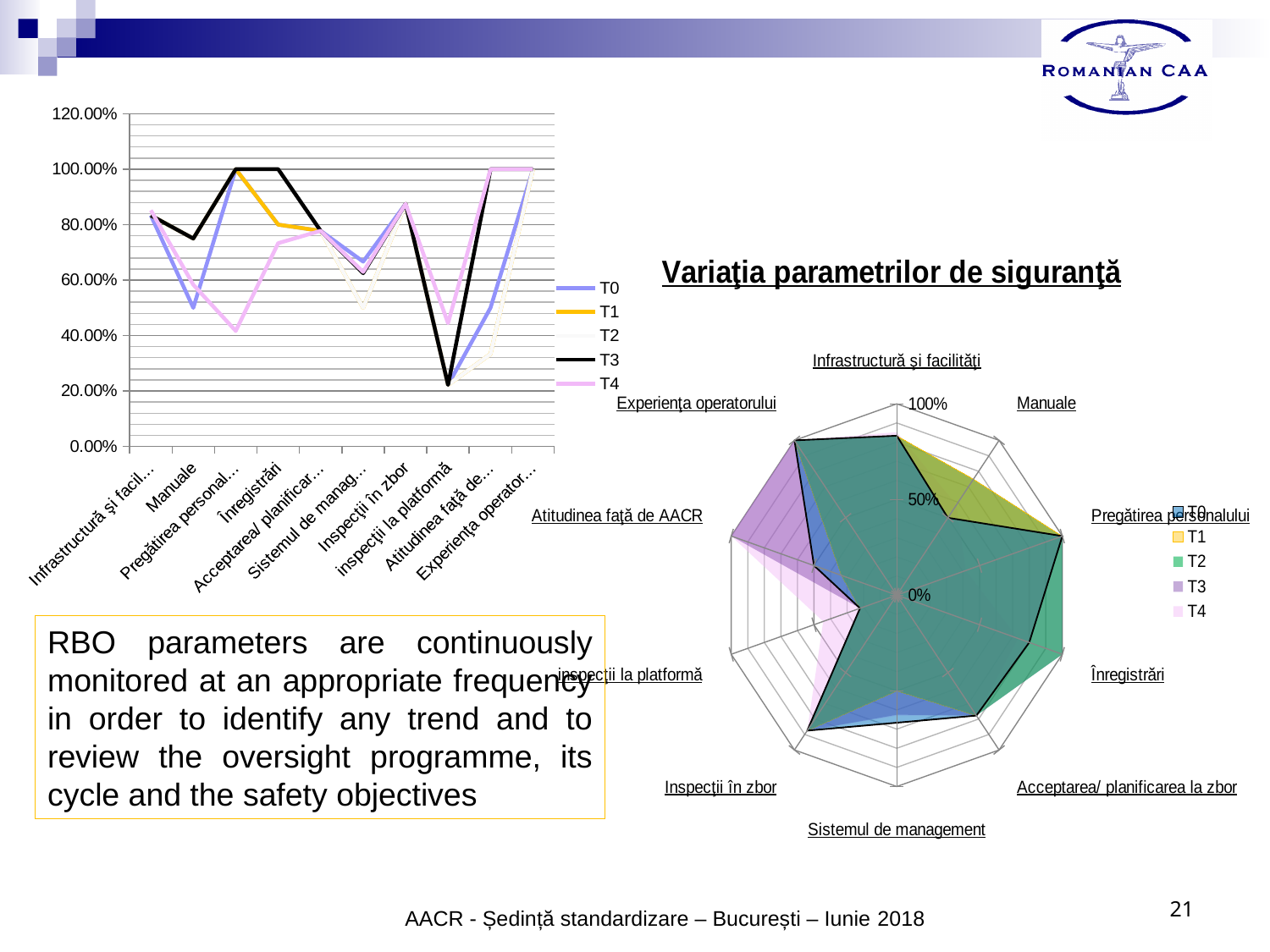
In the line chart on the left, how many series does the legend list? 5 What kind of chart is the chart on the left of the slide? line chart In the line chart on the left, how many categories are shown on the x axis? 10 In the chart titled 'Variaţia parametrilor de siguranţă', how many axes (parameters) are shown around the radar? 10 In the line chart on the left, is the value of T1 for 'Pregătirea personal...' greater or less than 80.00%? greater In the line chart on the left, is the value of T3 for 'Înregistrări' greater or less than 80.00%? greater In the chart titled 'Variaţia parametrilor de siguranţă', how many series does the legend list? 5 In the line chart on the left, is the value of T3 for 'Inspecţii la platformă' greater or less than 40.00%? less In the line chart on the left, what is the highest value shown on the y axis? 120.00% What is the title of the radar chart on the right of the slide? Variaţia parametrilor de siguranţă What kind of chart is the chart titled 'Variaţia parametrilor de siguranţă'? radar chart